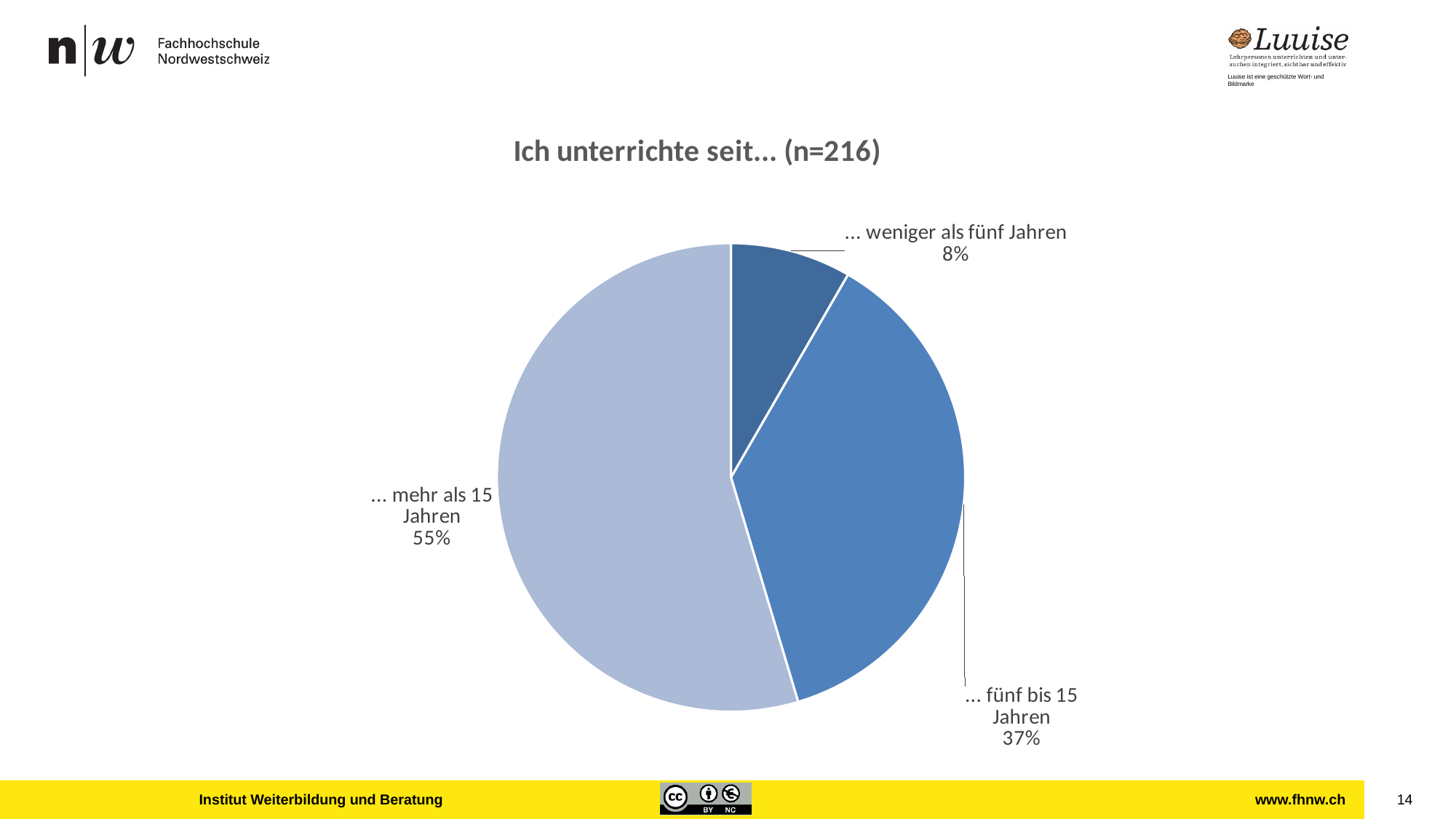
What is the title of the chart? Ich unterrichte seit... (n=216) What is the difference in percentage points between "... fünf bis 15 Jahren" and "... weniger als fünf Jahren"? 29 percentage points What share of respondents have been teaching for more than 15 years ("... mehr als 15 Jahren")? 55% What kind of chart is shown on the slide? pie chart What is the difference in percentage points between "... mehr als 15 Jahren" and "... fünf bis 15 Jahren"? 18 percentage points What is the sample size (n) stated in the chart title? 216 Which category has the smallest share of the pie? ... weniger als fünf Jahren Which category has the largest share of the pie? ... mehr als 15 Jahren What share of respondents have been teaching for less than five years ("... weniger als fünf Jahren")? 8% How many slices does the pie chart have? 3 What share of respondents have been teaching for five to 15 years ("... fünf bis 15 Jahren")? 37% Which is larger: the share for "... fünf bis 15 Jahren" or the share for "... weniger als fünf Jahren"? ... fünf bis 15 Jahren